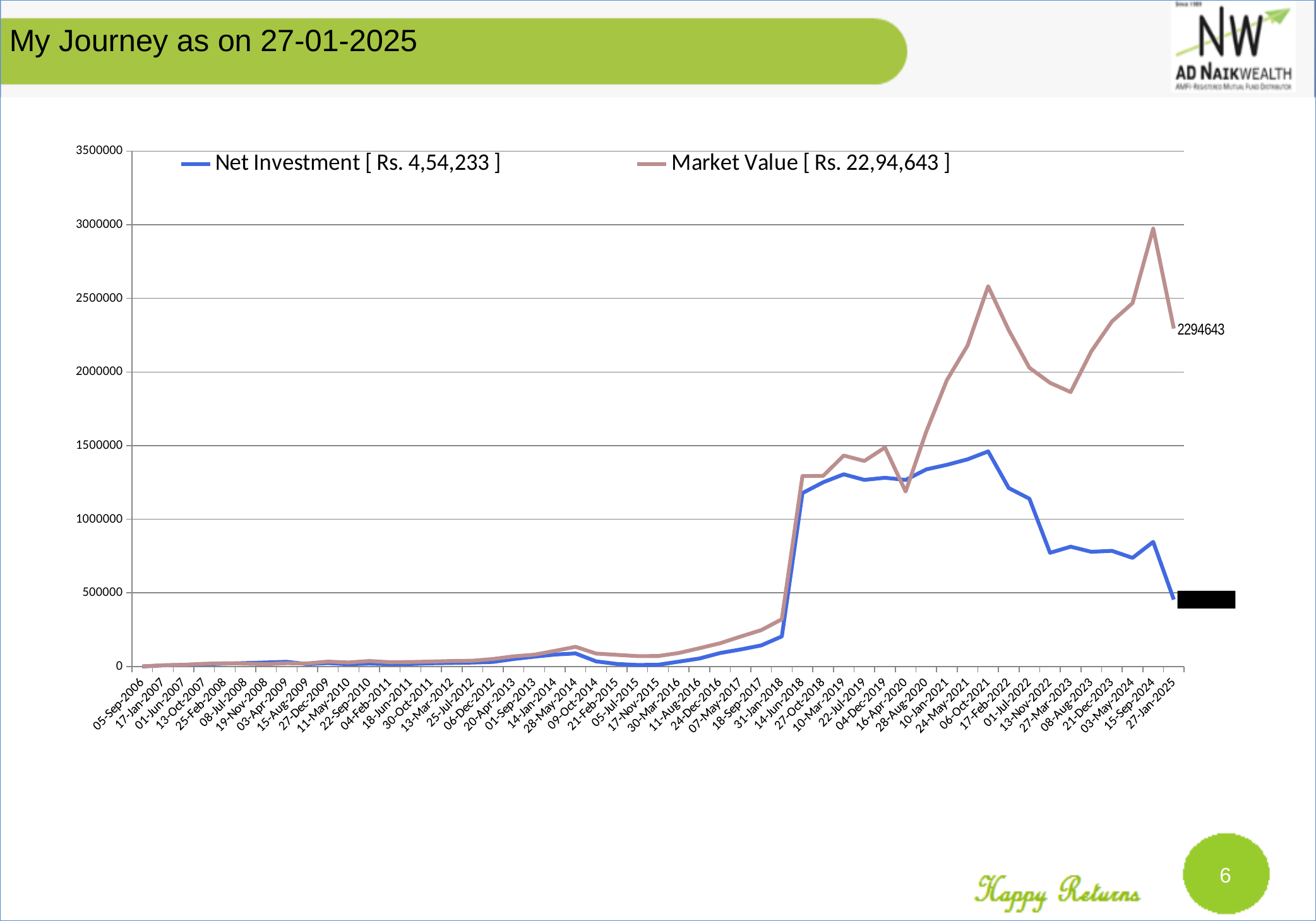
What is the title of the slide? My Journey as on 27-01-2025 Is the Market Value on 15-Sep-2024 greater or less than 2500000? greater Which series reaches the highest value on the chart? Market Value What is the Market Value data label shown at the end of the line on 27-Jan-2025? 2294643 What Market Value amount is shown in the legend? Rs. 22,94,643 What kind of chart is shown on the slide? line chart On 27-Jan-2025, which is larger, Market Value or Net Investment? Market Value How many series does the legend list? 2 Is the Market Value on 16-Apr-2020 greater or less than 1500000? less Does the Market Value line rise or fall between 15-Sep-2024 and 27-Jan-2025? fall Is the Net Investment on 06-Oct-2021 greater or less than 1000000? greater What Net Investment amount is shown in the legend? Rs. 4,54,233